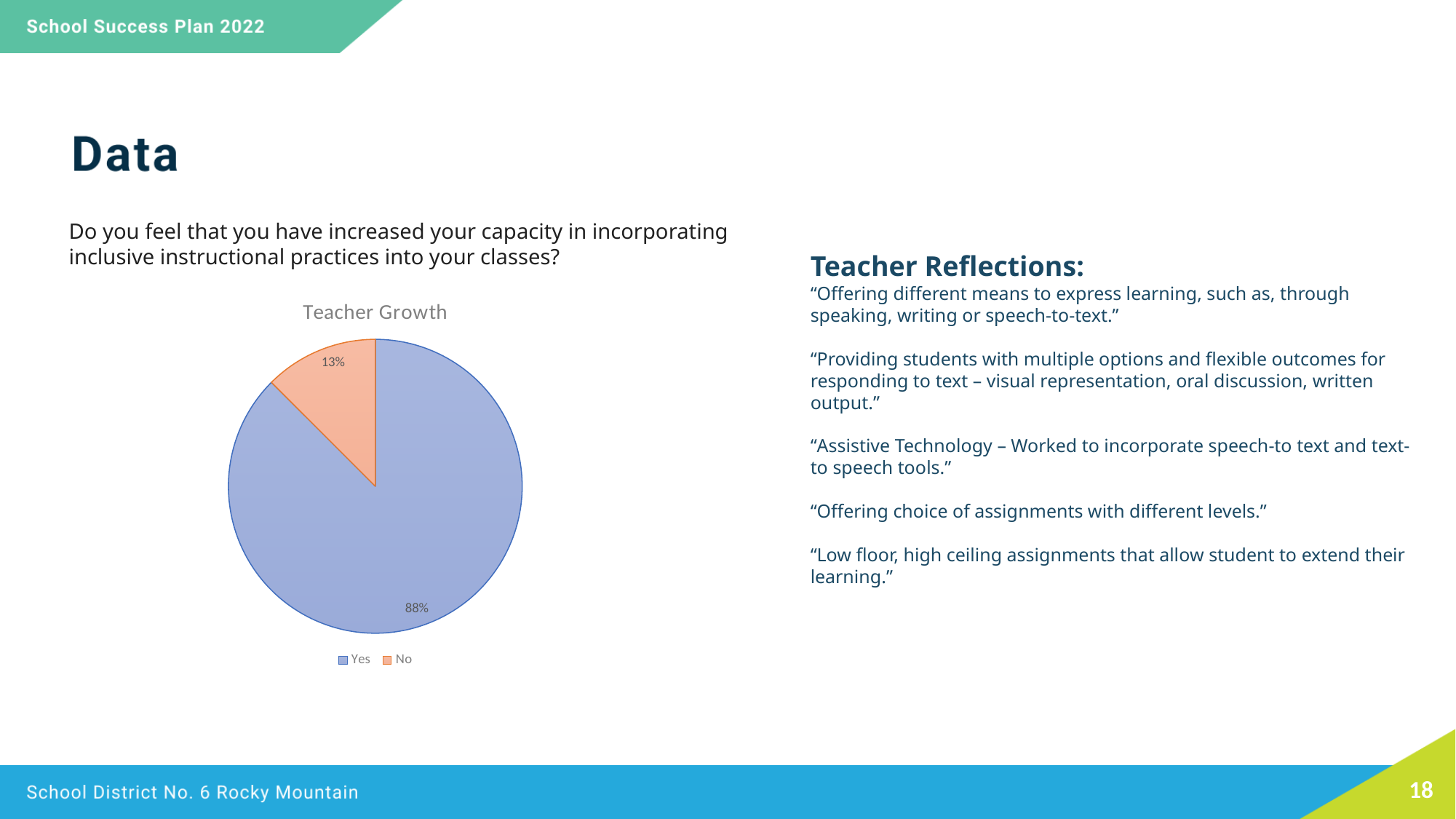
How many entries does the legend list? 2 What percentage of the pie is labelled "No"? 13% Which is larger, the "Yes" slice or the "No" slice? Yes What is the difference in percentage points between the "Yes" and "No" slices? 75 What percentage of the pie is labelled "Yes"? 88% What kind of chart is shown on the slide? pie chart Which slice of the pie is the smallest? No What colour is the "No" slice in the pie chart? orange Which slice of the pie is the largest? Yes What is the title of the chart? Teacher Growth How many slices does the pie chart have? 2